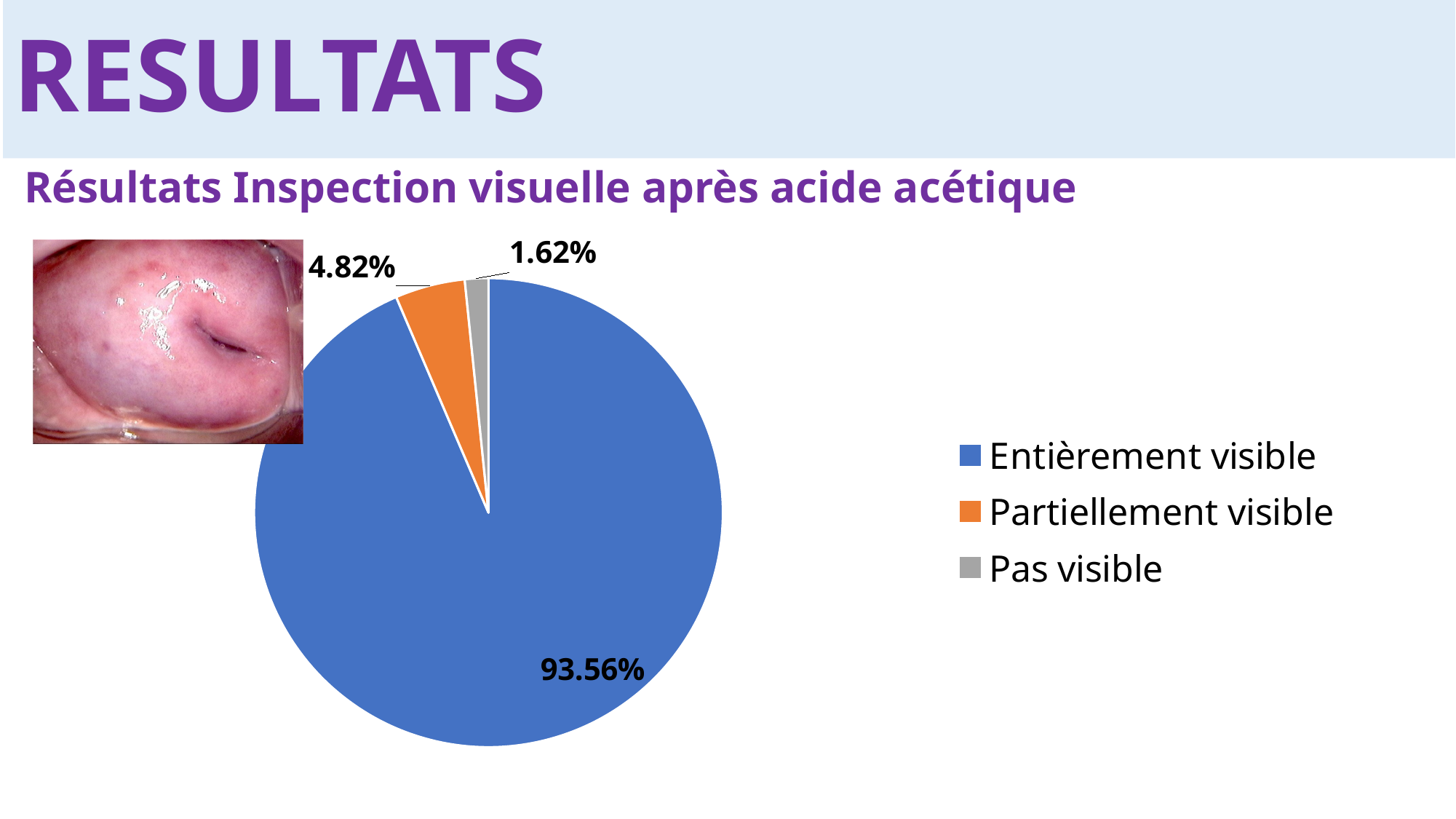
What percentage of the pie is labelled for Partiellement visible? 4.82% How many slices does the pie chart have? 3 How many entries does the legend list? 3 Which slice is larger, Partiellement visible or Pas visible? Partiellement visible Which category has the largest slice of the pie? Entièrement visible What percentage of the pie is labelled for Entièrement visible? 93.56% Which category has the smallest slice of the pie? Pas visible What is the subtitle above the pie chart? Résultats Inspection visuelle après acide acétique What percentage of the pie is labelled for Pas visible? 1.62% What kind of chart is shown on the slide? pie chart What colour is the Partiellement visible slice? orange What is the difference in percentage points between the Partiellement visible and Pas visible slices? 3.20